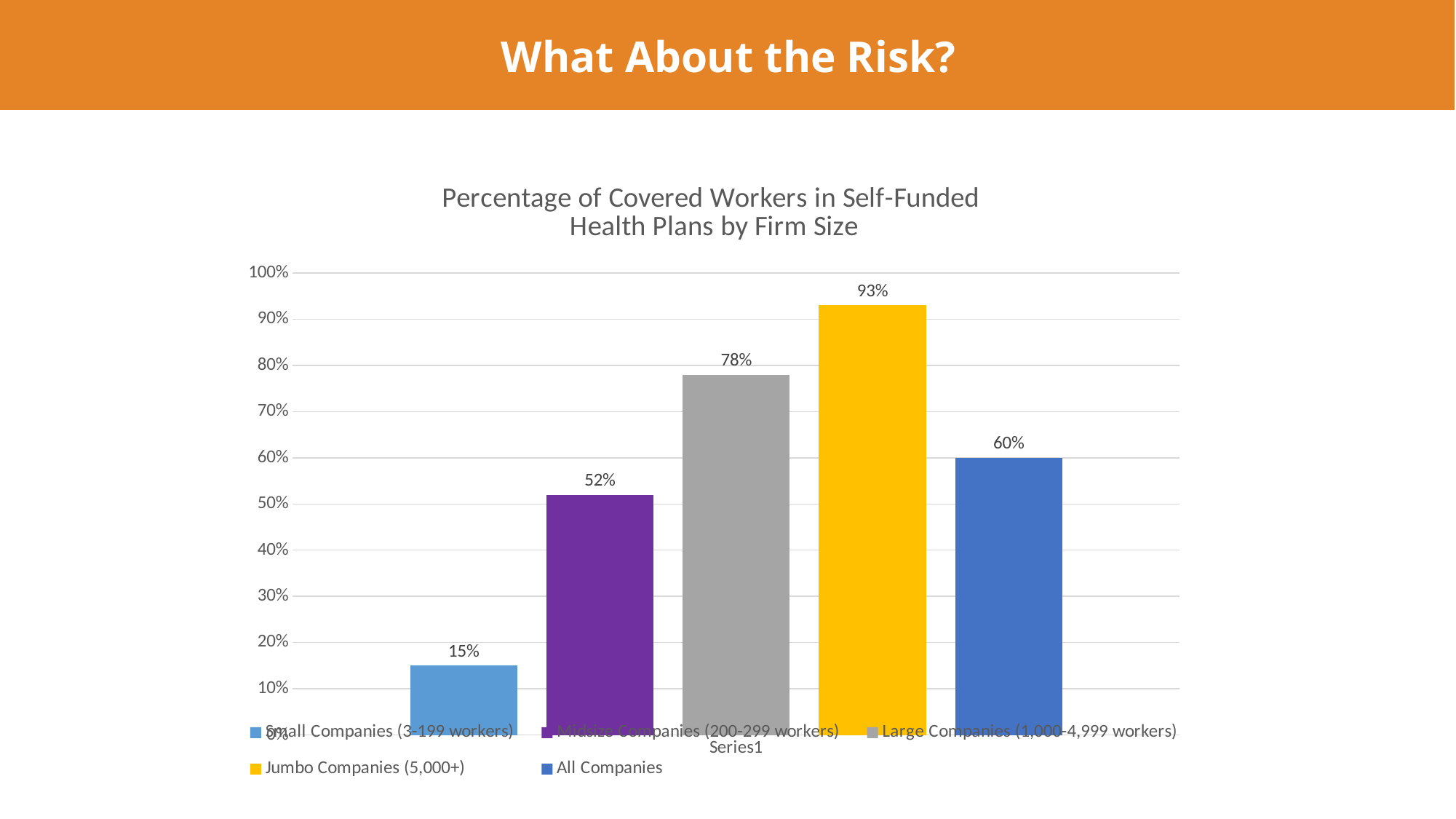
What is the value for Small Companies (3-199 workers)? 15% What kind of chart is shown on the slide? Bar chart What is the value for Jumbo Companies (5,000+)? 93% What is the title of the chart? Percentage of Covered Workers in Self-Funded Health Plans by Firm Size What is the value for All Companies? 60% Which category has the lowest percentage of covered workers in self-funded health plans? Small Companies (3-199 workers) Which category has the highest percentage of covered workers in self-funded health plans? Jumbo Companies (5,000+) Which is larger, the value for Large Companies (1,000-4,999 workers) or the value for All Companies? Large Companies (1,000-4,999 workers) What is the value for Midsize Companies (200-299 workers)? 52% Is the value for Midsize Companies (200-299 workers) greater or less than 50%? greater How many bars are plotted in the chart? 5 What is the difference between the values for Jumbo Companies (5,000+) and Large Companies (1,000-4,999 workers)? 15%